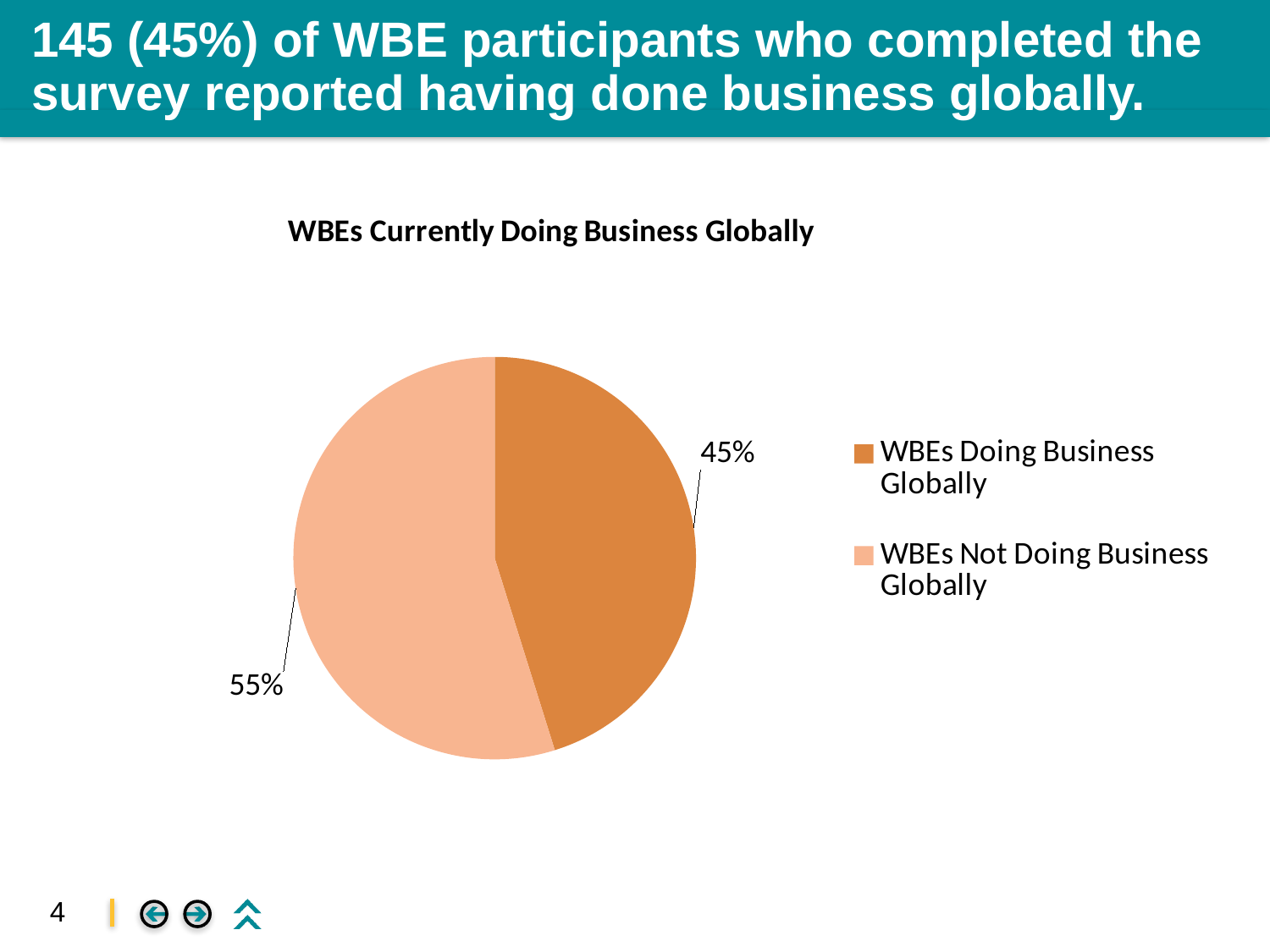
How many slices does the pie chart have? 2 How many entries does the legend list? 2 What kind of chart is shown on the slide? pie chart What is the difference in percentage points between the WBEs Not Doing Business Globally slice and the WBEs Doing Business Globally slice? 10 Which slice is the smallest? WBEs Doing Business Globally What share of the pie is WBEs Doing Business Globally? 45% Which legend entry is shown in the darker orange colour? WBEs Doing Business Globally What is the title of the chart? WBEs Currently Doing Business Globally What share of the pie is WBEs Not Doing Business Globally? 55% Which slice is the largest? WBEs Not Doing Business Globally Which is larger, the WBEs Doing Business Globally slice or the WBEs Not Doing Business Globally slice? WBEs Not Doing Business Globally